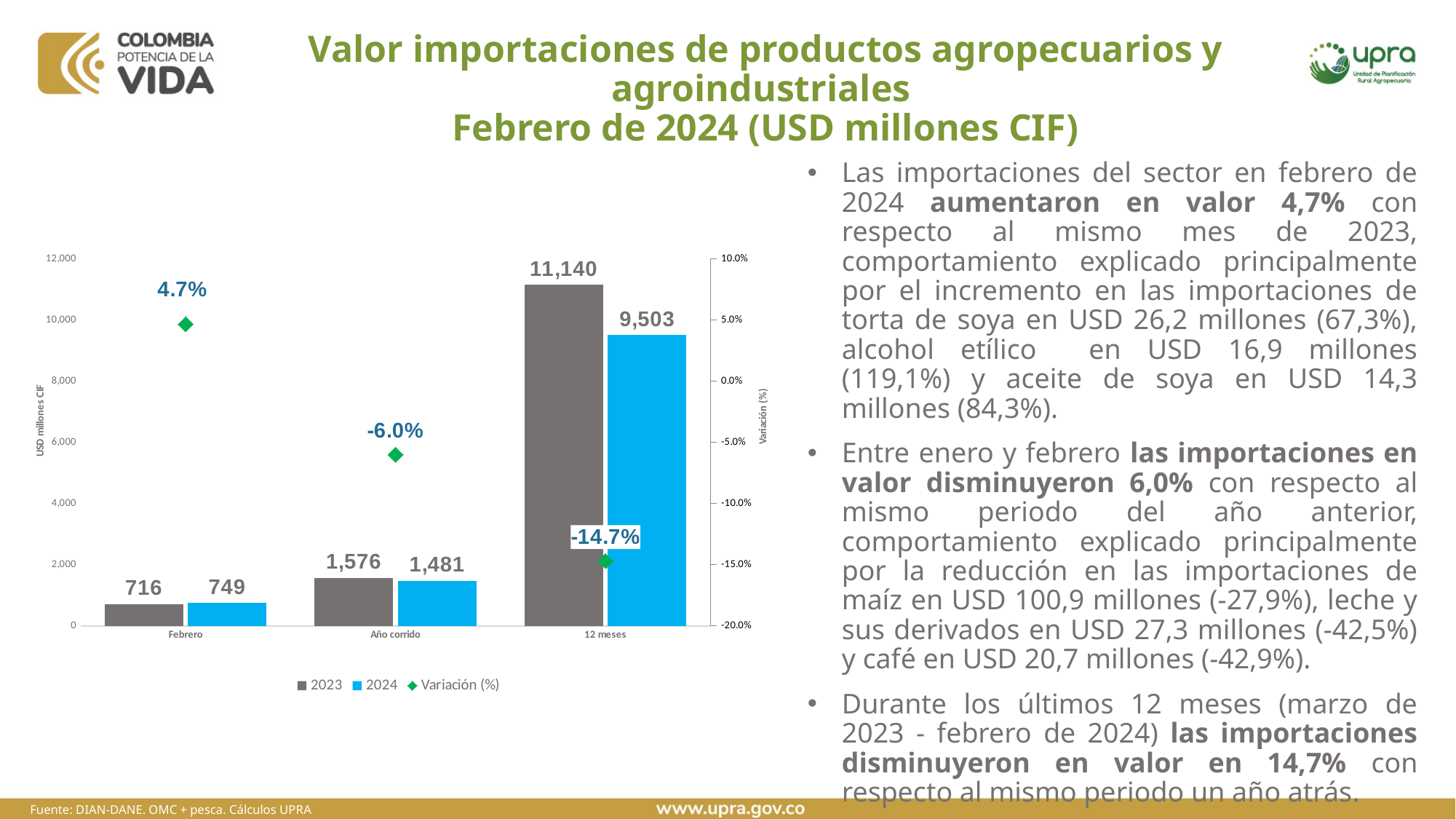
What is the Variación (%) shown for Año corrido? -6.0% What is the Variación (%) shown for 12 meses? -14.7% What is the label of the left vertical axis? USD millones CIF Which category has the highest value for the 2023 series? 12 meses How many series does the legend list? 3 What is the value for 2024 in the 12 meses category? 9,503 What kind of chart is used to show the 2023 and 2024 values? Bar chart In the Año corrido category, which is larger, the 2023 value or the 2024 value? 2023 What is the difference between the 2023 and 2024 values in the 12 meses category? 1,637 Which category has the lowest value for the 2024 series? Febrero How many categories are shown on the x axis? 3 What is the value for 2023 in the Febrero category? 716